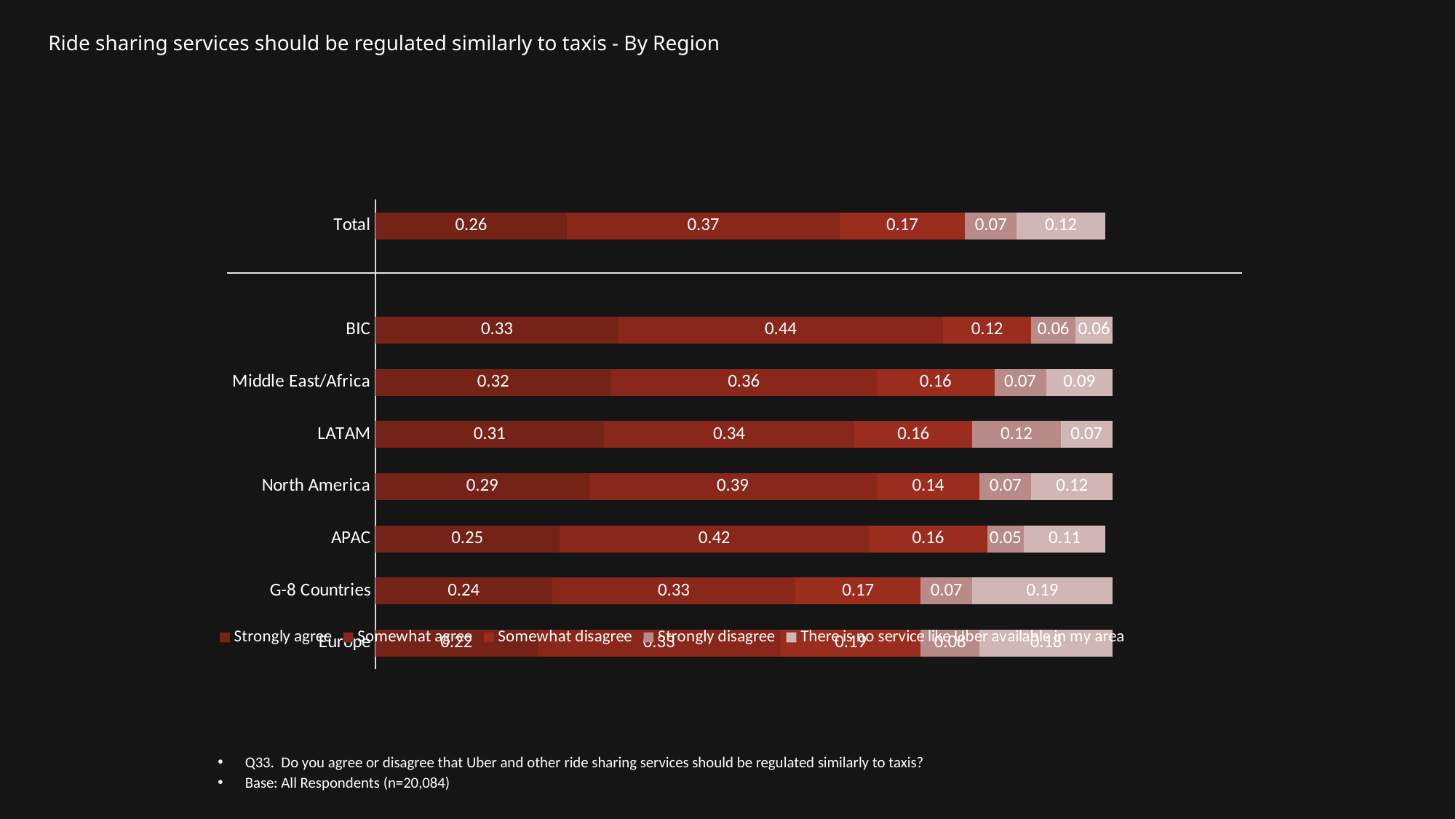
Which region has the highest value for 'There is no service like Uber available in my area'? G-8 Countries What kind of chart is shown on the slide? Stacked bar chart Which has the larger Somewhat disagree value, Total or North America? Total What is the Somewhat agree value for APAC? 0.42 What is the Strongly agree value for BIC? 0.33 What is the Strongly disagree value for LATAM? 0.12 Which region has the lowest Strongly disagree value? APAC What is the total of the LATAM stacked bar? 1.00 How many series does the legend list? 5 What is the difference between the Somewhat agree values for BIC and G-8 Countries? 0.11 How many bars (including Total) are plotted in the chart? 8 Which region has the highest Strongly agree value? BIC